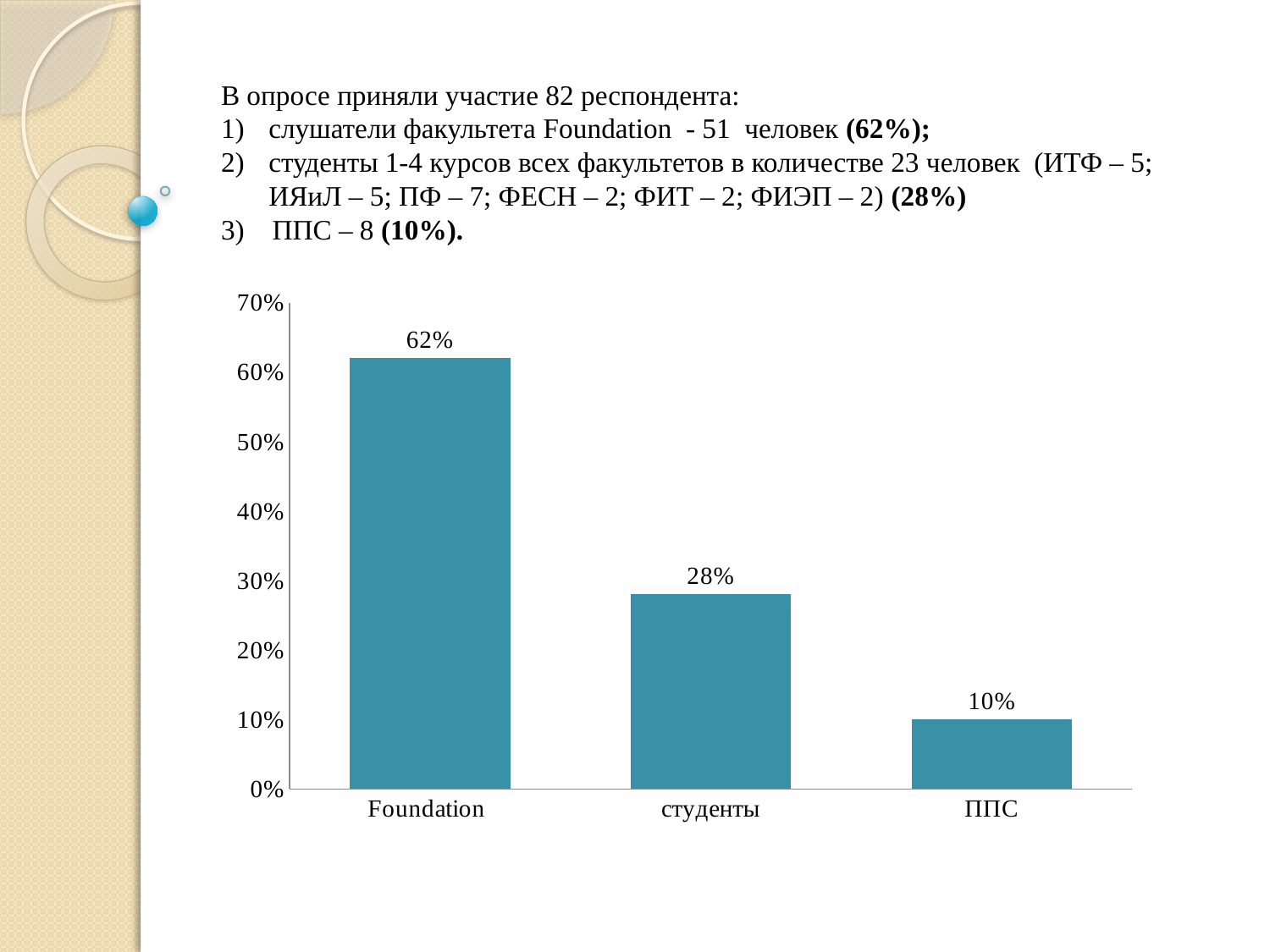
Which is larger, the value for студенты or the value for ППС? студенты What is the difference between the values for Foundation and студенты? 34% What is the value for Foundation? 62% Is the value for Foundation greater or less than 50%? greater Which category has the lowest value? ППС What is the value for студенты? 28% What kind of chart is shown on the slide? bar chart How many categories are shown on the x axis? 3 Which category has the highest value? Foundation What is the difference between the values for студенты and ППС? 18% Do the values rise or fall from left to right along the x axis? fall What is the value for ППС? 10%